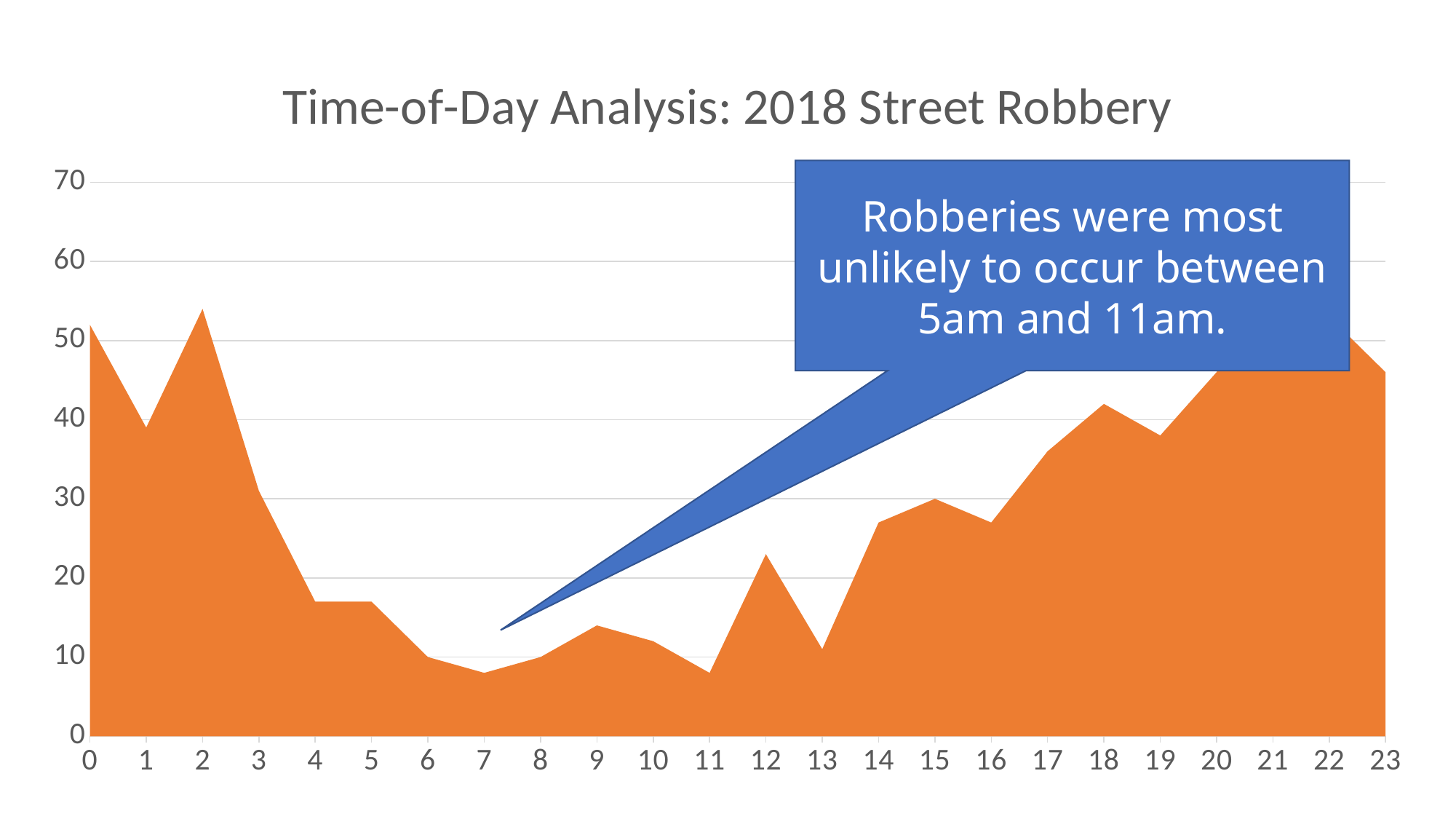
What kind of chart is shown on the slide? Area chart Is the value for hour 12 greater or less than 20? greater Which hour has the higher value, hour 2 or hour 7? Hour 2 According to the callout on the chart, between which hours were robberies most unlikely to occur? Between 5am and 11am Is the value for hour 20 greater or less than 40? greater Is the value for hour 17 greater or less than 30? greater What is the title of the chart? Time-of-Day Analysis: 2018 Street Robbery Which hour has the higher value, hour 12 or hour 13? Hour 12 How many hours (data points) are plotted along the x axis? 24 Do the values rise or fall from hour 2 to hour 7? Fall